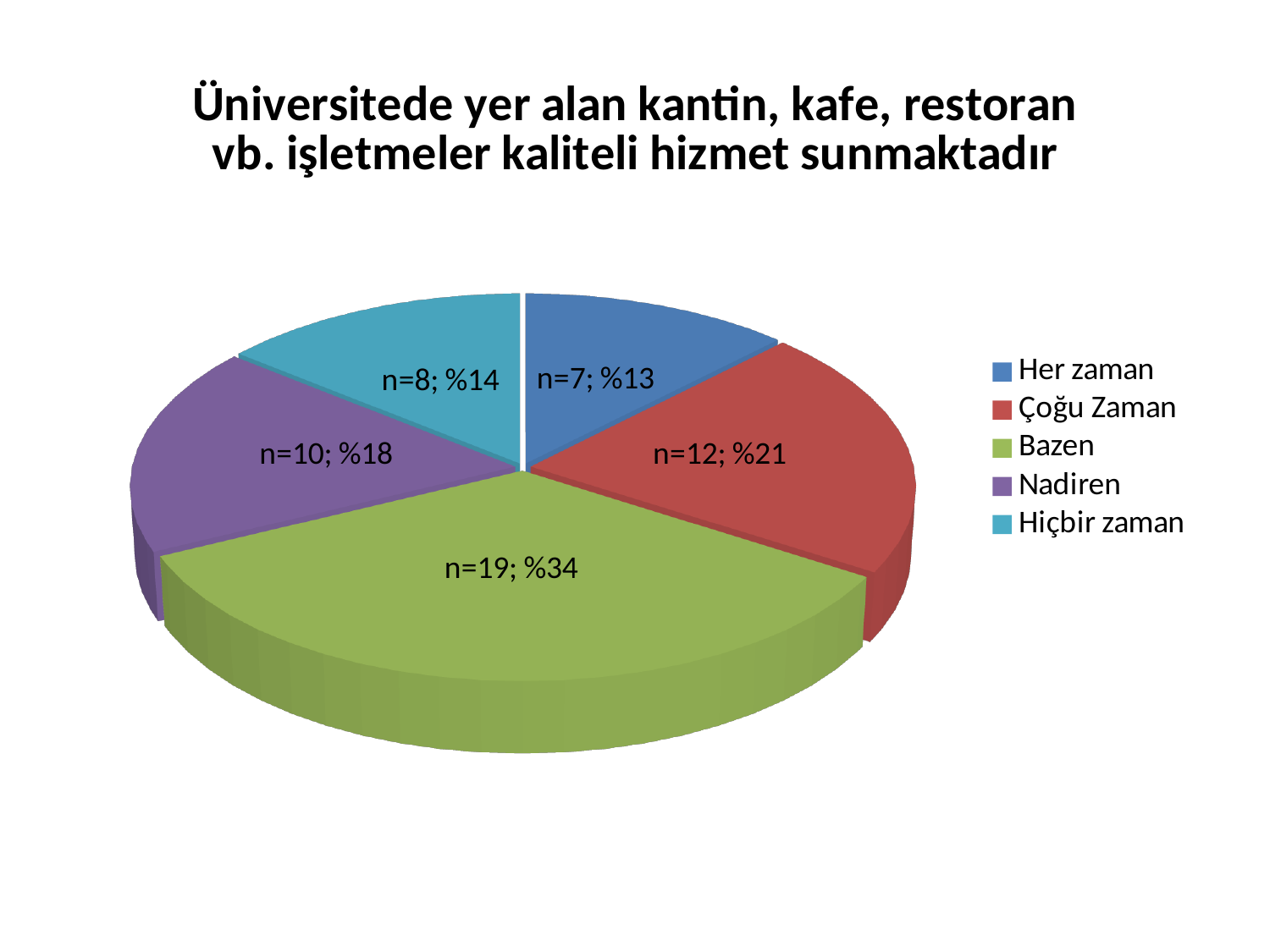
What is the count (n) for the 'Hiçbir zaman' slice? n=8 What is the difference in count (n) between 'Bazen' and 'Çoğu Zaman'? 7 What is the count (n) for the 'Bazen' slice? n=19 Which has a larger count, 'Nadiren' or 'Hiçbir zaman'? Nadiren What kind of chart is shown on the slide? pie chart What percentage is shown for the 'Nadiren' slice? %18 Which category has the smallest slice? Her zaman Which category has the largest slice? Bazen What is the count (n) for the 'Her zaman' slice? n=7 What is the title of the chart? Üniversitede yer alan kantin, kafe, restoran vb. işletmeler kaliteli hizmet sunmaktadır How many slices does the pie chart have? 5 What percentage is shown for the 'Çoğu Zaman' slice? %21